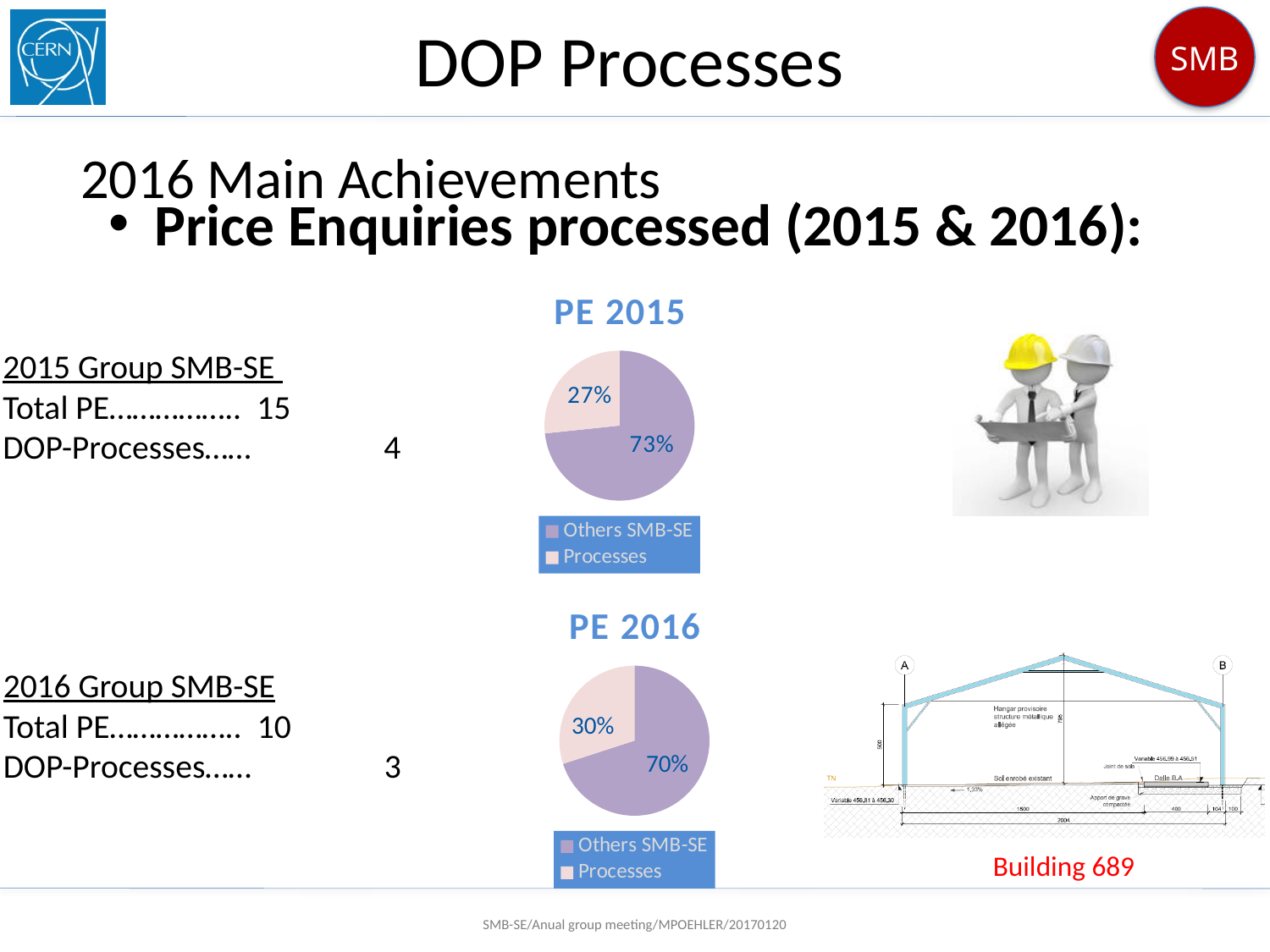
How many slices does the PE 2016 pie chart have? 2 In the PE 2016 chart, which slice is the smallest? Processes In the PE 2015 chart, which slice is the largest? Others SMB-SE In the PE 2015 chart, what share does Processes have? 27% In the PE 2016 chart, what share does Processes have? 30% In the PE 2015 chart, what share does Others SMB-SE have? 73% How many entries does the legend of the PE 2015 chart list? 2 What is the title of the lower pie chart on the slide? PE 2016 In the PE 2016 chart, what is the difference between the Others SMB-SE share and the Processes share? 40% In the PE 2016 chart, what share does Others SMB-SE have? 70% Is the Processes share larger in the PE 2015 chart or the PE 2016 chart? PE 2016 What kind of chart is the PE 2015 chart? Pie chart